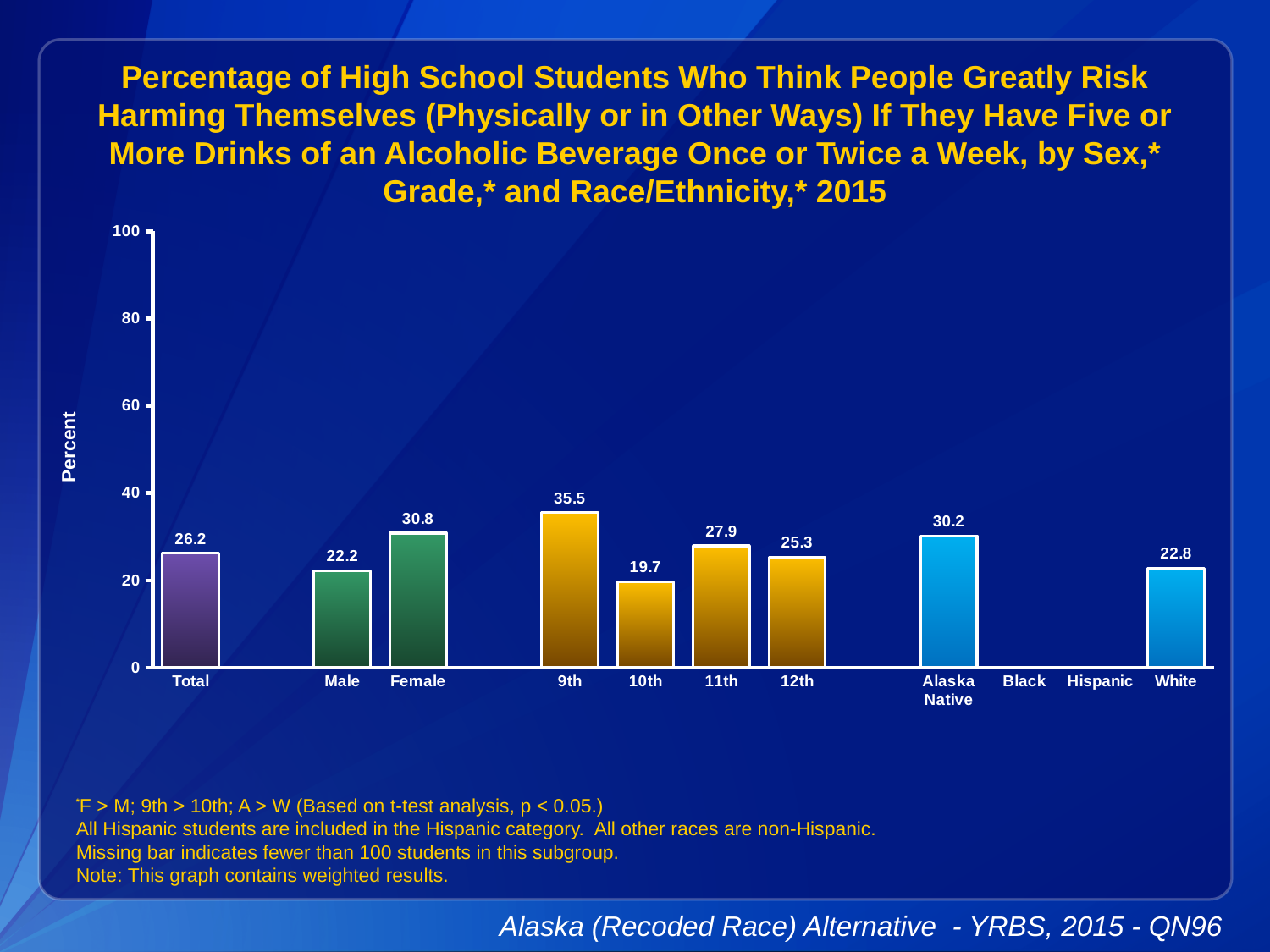
What kind of chart is shown on the slide? bar chart Is the value for 9th grade greater or less than 40? less What is the value for Alaska Native? 30.2 What is the value for 10th grade? 19.7 Which category has the highest value? 9th What is the difference between the Female and Male values? 8.6 Which category has the lowest value among the bars shown? 10th How many bars are plotted on the chart? 9 What is the value for Female? 30.8 Which is larger, the value for 11th grade or 12th grade? 11th Which race/ethnicity categories have no bar shown? Black and Hispanic What is the value for Total? 26.2